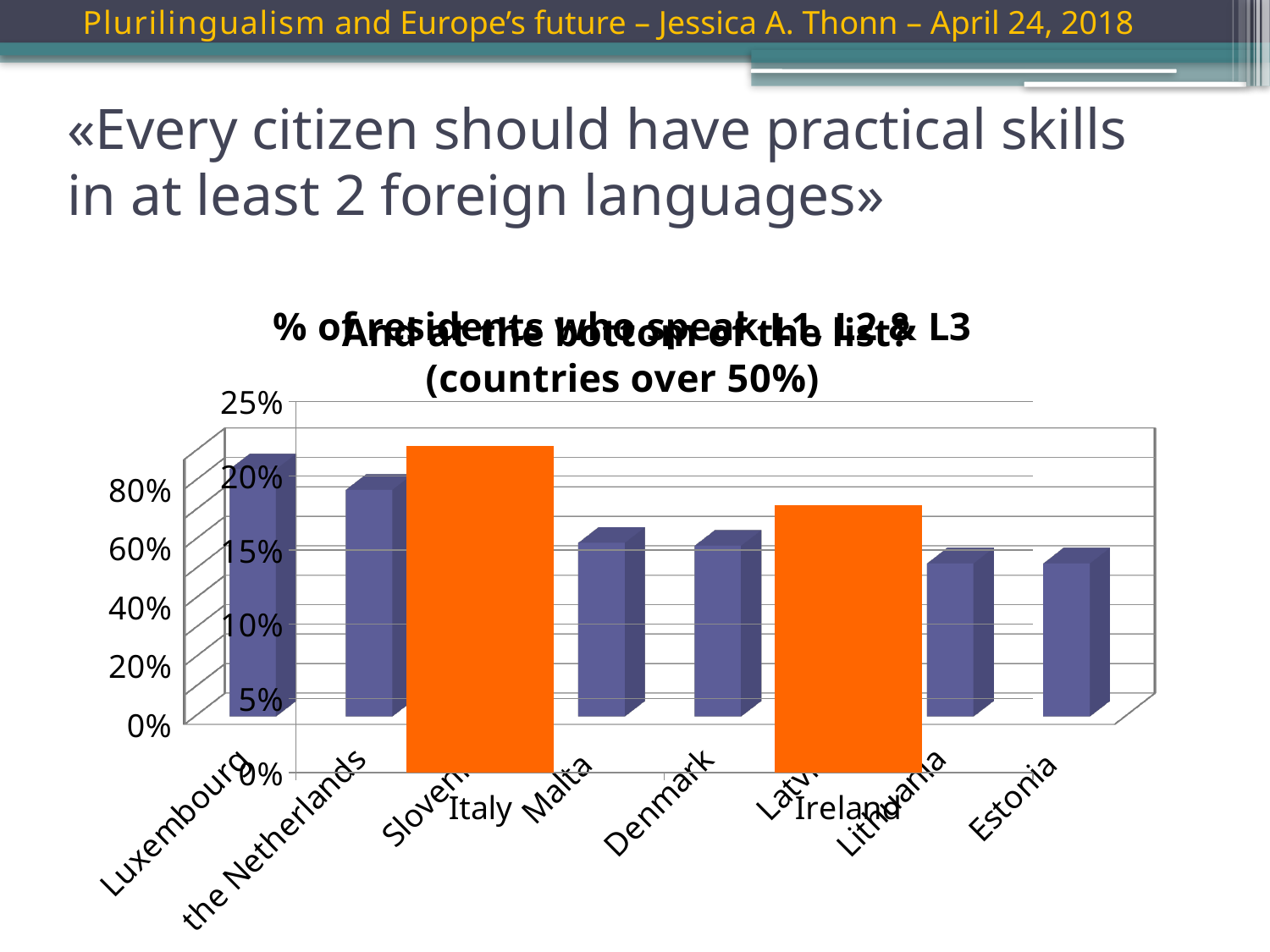
On the chart titled 'And at the bottom of the list?', which country has the higher value, Italy or Ireland? Italy On the chart titled '% of residents who speak L1, L2 & L3 (countries over 50%)', is the value for Estonia greater or less than 40%? greater On the chart titled '% of residents who speak L1, L2 & L3 (countries over 50%)', which is higher, Luxembourg or Malta? Luxembourg On the chart titled '% of residents who speak L1, L2 & L3 (countries over 50%)', which country has the highest value? Luxembourg On the chart titled 'And at the bottom of the list?', is the value for Italy greater or less than 20%? greater On the chart titled '% of residents who speak L1, L2 & L3 (countries over 50%)', is the value for Malta greater or less than 80%? less What type of chart is the chart titled 'And at the bottom of the list?'? bar chart On the chart titled 'And at the bottom of the list?', how many countries are plotted? 2 On the chart titled '% of residents who speak L1, L2 & L3 (countries over 50%)', how many countries are plotted? 8 On the chart titled '% of residents who speak L1, L2 & L3 (countries over 50%)', which is higher, the Netherlands or Denmark? the Netherlands